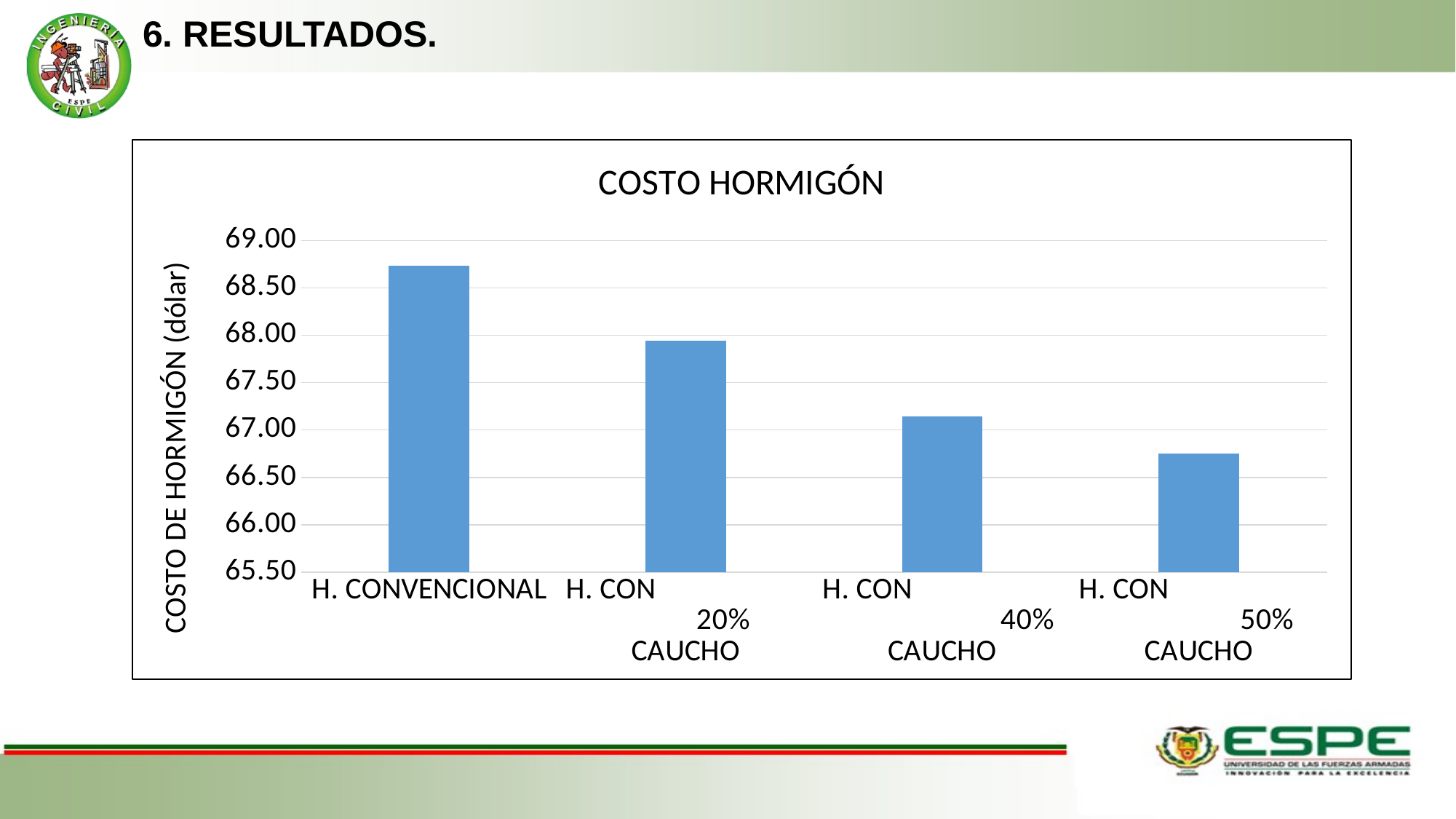
Is the value for H. CON 20% CAUCHO greater or less than 67.50? greater Which category has the lowest cost? H. CON 50% CAUCHO Which is larger, the cost for H. CONVENCIONAL or for H. CON 40% CAUCHO? H. CONVENCIONAL What is the label of the vertical axis? COSTO DE HORMIGÓN (dólar) Is the value for H. CONVENCIONAL greater or less than 68.50? greater Which category has the highest cost? H. CONVENCIONAL Do the values rise or fall from left to right across the categories? Fall How many categories are plotted in the chart? 4 What type of chart is shown on the slide? Bar chart Is the value for H. CON 50% CAUCHO greater or less than 67.00? less Which is larger, the cost for H. CON 20% CAUCHO or for H. CON 50% CAUCHO? H. CON 20% CAUCHO What is the title of the chart? COSTO HORMIGÓN